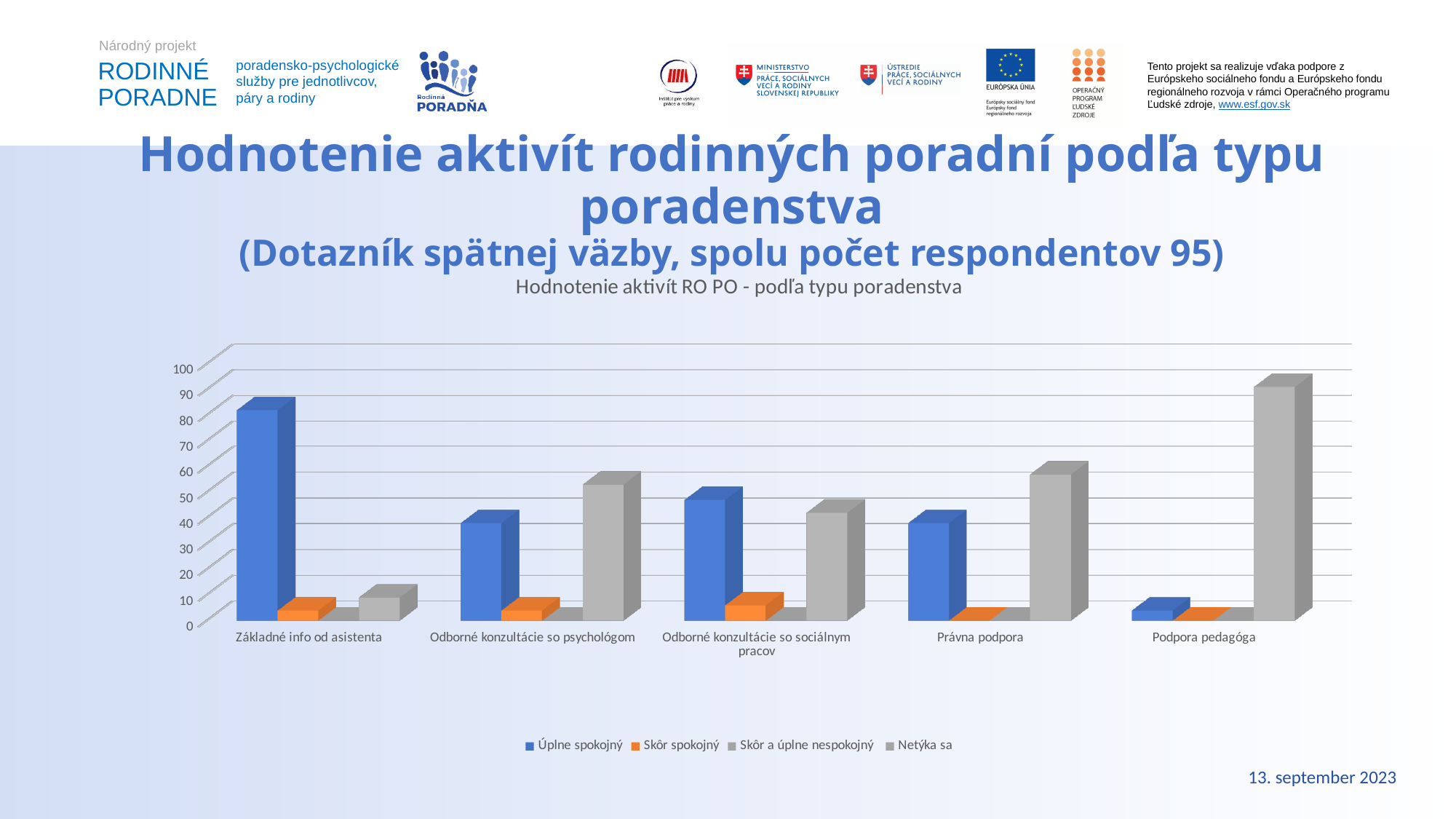
What is the title of the chart? Hodnotenie aktivít RO PO - podľa typu poradenstva Is the value of Úplne spokojný for Základné info od asistenta greater or less than 70? greater What kind of chart is shown on the slide? bar chart Which category has the highest value for the series Úplne spokojný? Základné info od asistenta Which category has the highest value for the series Netýka sa? Podpora pedagóga Which category has the lowest value for the series Úplne spokojný? Podpora pedagóga How many categories are shown on the x axis of the chart? 5 Which is larger: the Netýka sa value for Právna podpora or for Základné info od asistenta? Právna podpora Is the value of Úplne spokojný for Podpora pedagóga greater or less than 20? less How many series does the legend list? 4 Is the value of Netýka sa for Podpora pedagóga greater or less than 80? greater